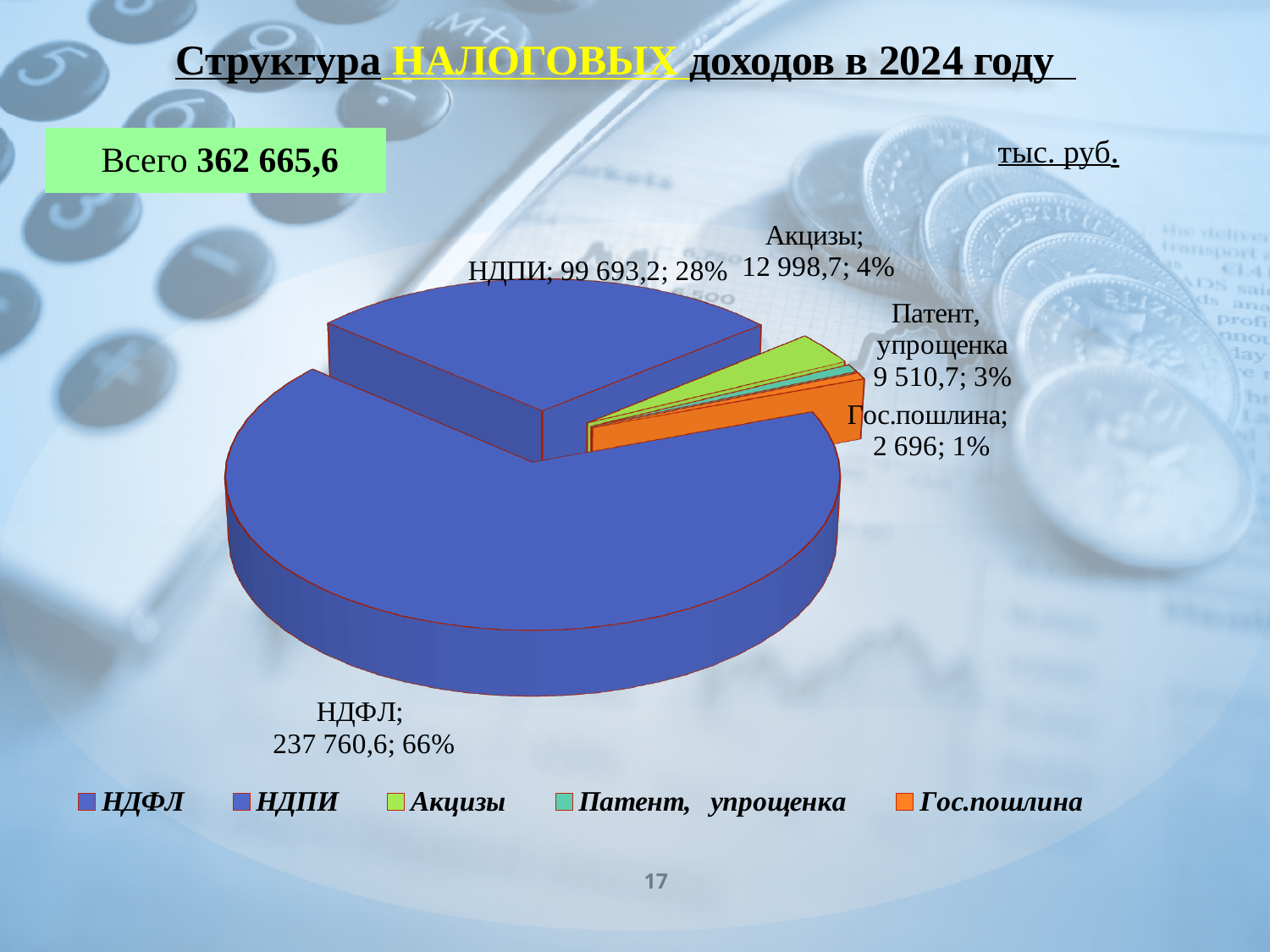
How many categories does the legend list? 5 What share of the pie does НДФЛ represent? 66% What is the difference between the values for НДФЛ and НДПИ? 138 067,4 Which is larger, the value for Акцизы or the value for Патент, упрощенка? Акцизы What is the value for НДФЛ? 237 760,6 What is the value for Гос.пошлина? 2 696 What is the value for НДПИ? 99 693,2 Which category has the largest slice? НДФЛ What type of chart is shown on the slide? pie chart What share of the pie does Патент, упрощенка represent? 3% Which category has the smallest slice? Гос.пошлина What is the value for Акцизы? 12 998,7